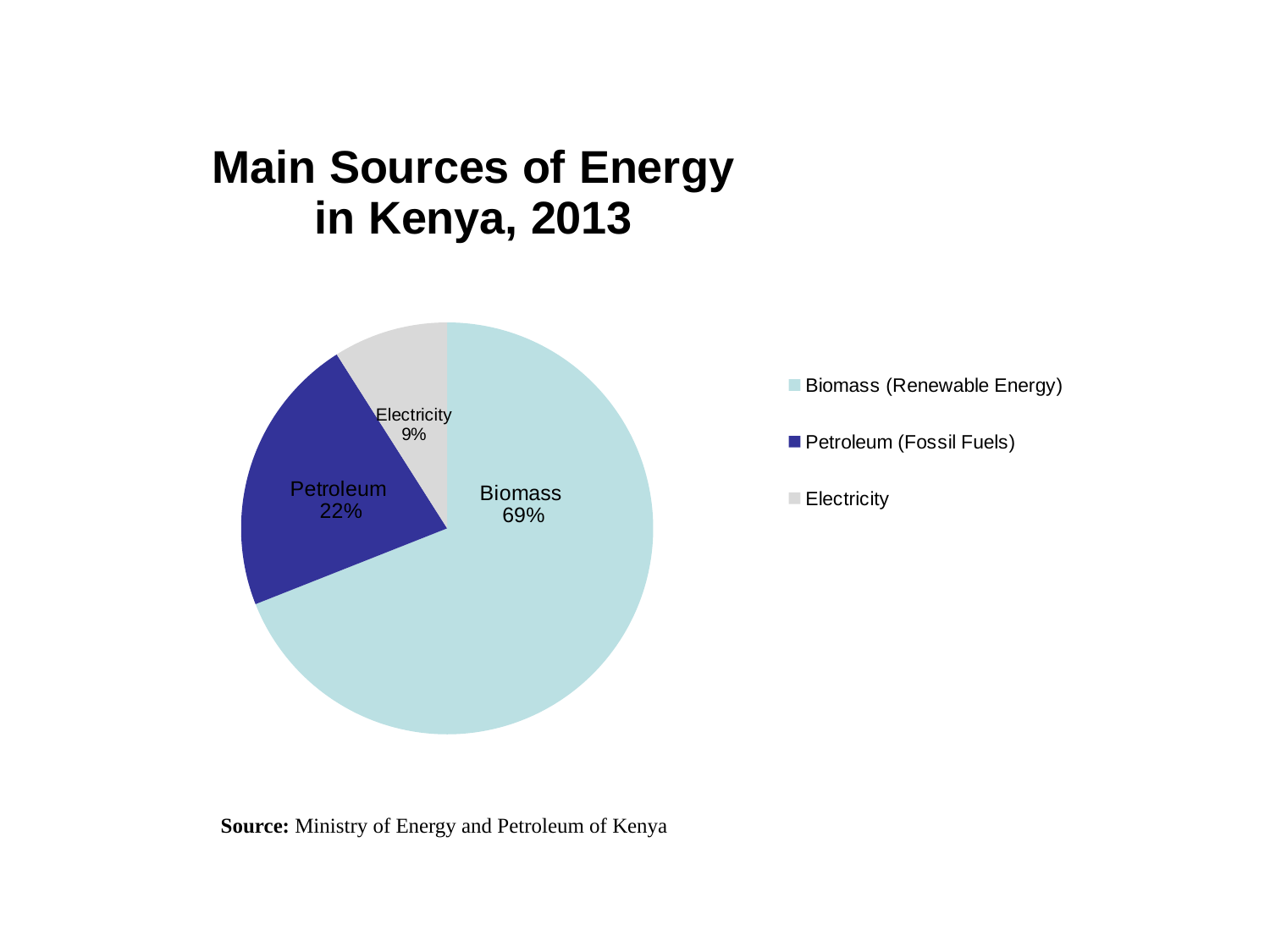
What is the difference in percentage points between the Petroleum and Electricity shares? 13 Which energy source has the largest share of the pie? Biomass According to the legend, what is the full label for the Biomass slice? Biomass (Renewable Energy) What share of energy sources does Electricity account for? 9% What share of energy sources does Petroleum account for? 22% Which has a larger share, Petroleum or Electricity? Petroleum What kind of chart is shown on the slide? Pie chart What is the title of the chart? Main Sources of Energy in Kenya, 2013 What is the difference in percentage points between the Biomass and Petroleum shares? 47 How many slices does the pie chart have? 3 What share of energy sources does Biomass account for? 69% Which energy source has the smallest share of the pie? Electricity